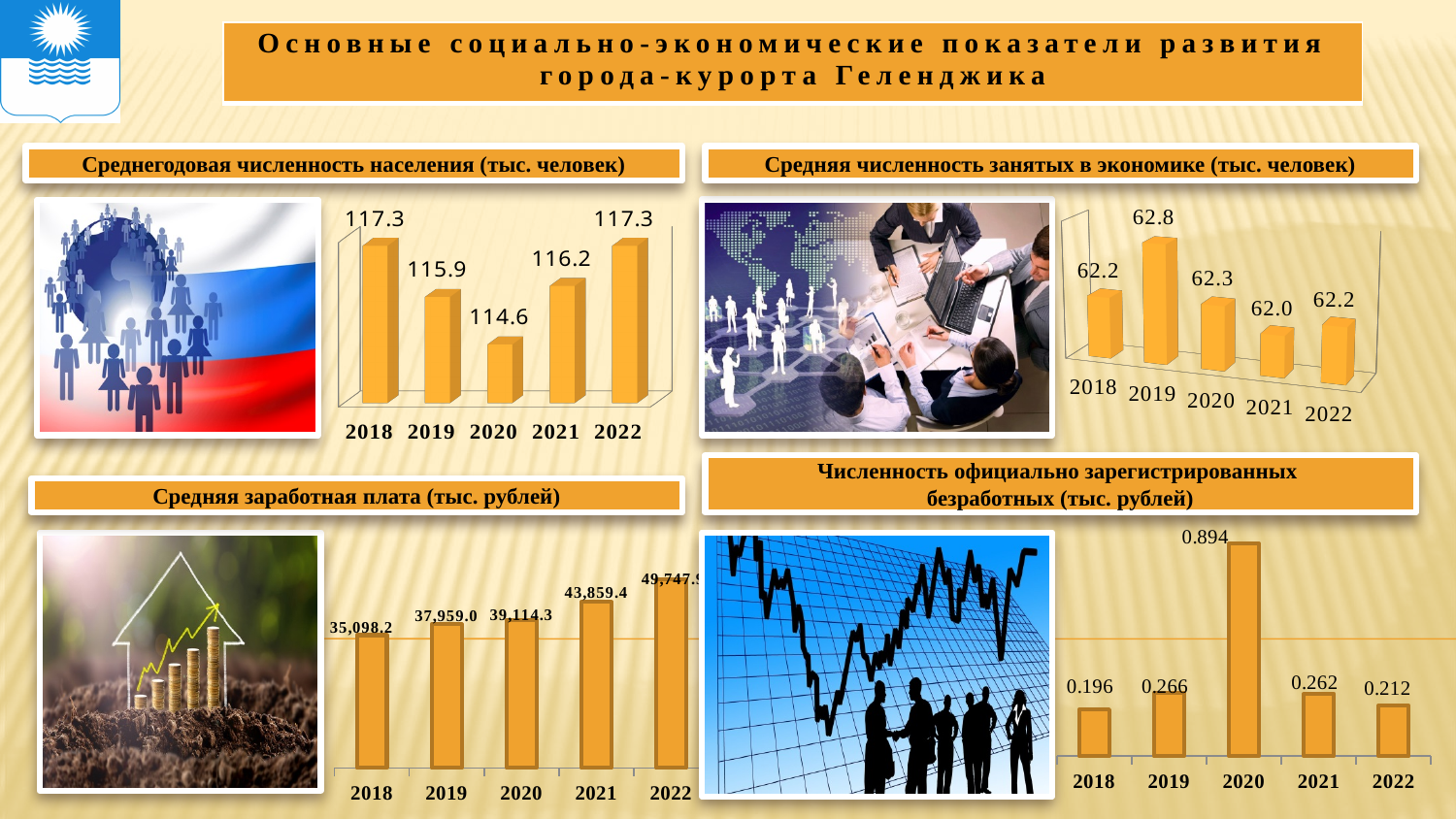
In the chart 'Среднегодовая численность населения (тыс. человек)', what is the difference between the 2022 value and the 2020 value? 2.7 In the chart 'Средняя численность занятых в экономике (тыс. человек)', which year has the highest value? 2019 In the chart 'Средняя заработная плата (тыс. рублей)', what is the value for 2019? 37,959.0 In the chart 'Средняя численность занятых в экономике (тыс. человек)', what is the value for 2021? 62.0 In the chart 'Средняя численность занятых в экономике (тыс. человек)', how many years are shown on the x axis? 5 In the chart 'Среднегодовая численность населения (тыс. человек)', which year has the lowest value? 2020 In the chart 'Численность официально зарегистрированных безработных (тыс. рублей)', which is larger, the value for 2019 or the value for 2022? 2019 In the chart 'Численность официально зарегистрированных безработных (тыс. рублей)', which year has the highest value? 2020 In the chart 'Средняя заработная плата (тыс. рублей)', what is the difference between the 2021 value and the 2020 value? 4,745.1 In the chart 'Средняя заработная плата (тыс. рублей)', do the values rise or fall from 2018 to 2022? rise In the chart 'Среднегодовая численность населения (тыс. человек)', what is the value for 2020? 114.6 What kind of chart is used for 'Численность официально зарегистрированных безработных (тыс. рублей)'? bar chart